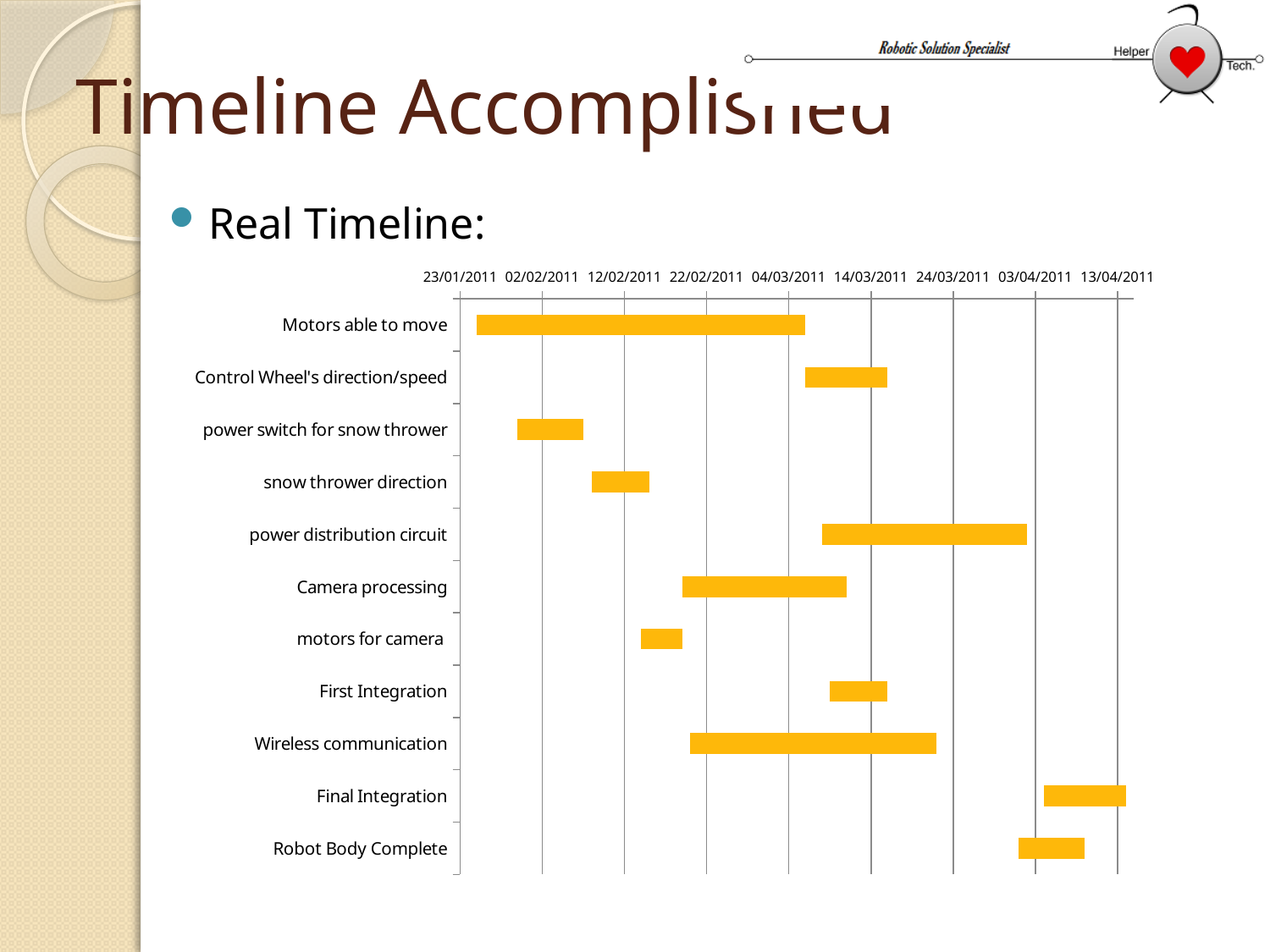
Does the bar for Motors able to move start before or after 02/02/2011? before What kind of chart is shown on the slide? Bar chart (Gantt chart) Which bar is longer, Wireless communication or Camera processing? Wireless communication Which task's bar ends latest in the chart? Final Integration What is the first date shown on the chart's horizontal axis? 23/01/2011 What is the last date shown on the chart's horizontal axis? 13/04/2011 Which bar is longer, Motors able to move or power distribution circuit? Motors able to move Which task has the longest bar in the chart? Motors able to move How many tasks are listed on the vertical axis of the chart? 11 Which task's bar starts earliest in the chart? Motors able to move Does the bar for Final Integration end before or after 03/04/2011? after Does the bar for Camera processing start before or after 22/02/2011? before